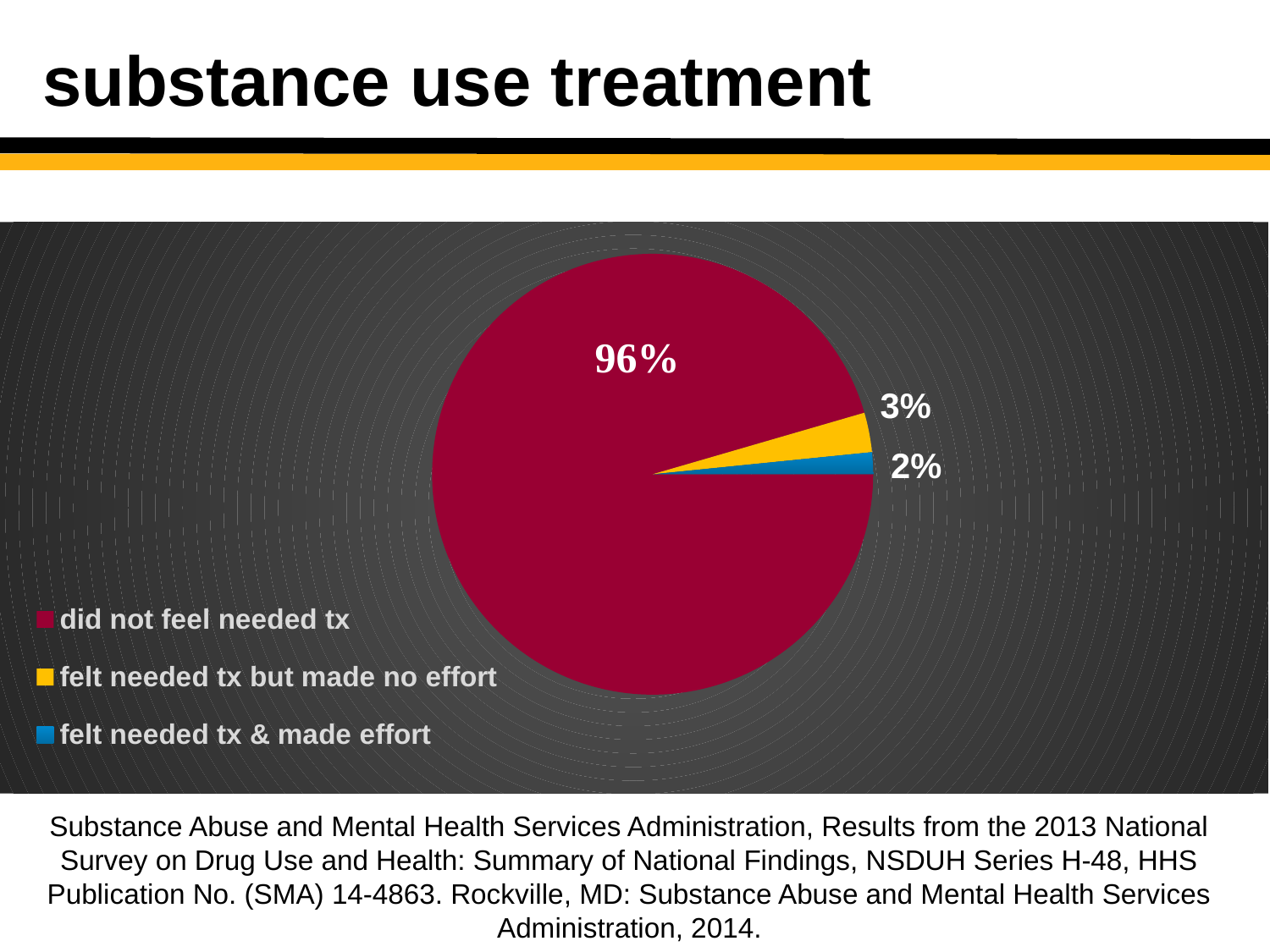
Which category has the smallest slice of the pie? felt needed tx & made effort What share of the pie is labelled "did not feel needed tx"? 96% What kind of chart is shown on the slide? pie chart Which is larger: the slice for "felt needed tx but made no effort" or the slice for "felt needed tx & made effort"? felt needed tx but made no effort What share of the pie is labelled "felt needed tx but made no effort"? 3% How many slices does the pie chart have? 3 What colour is the slice for "did not feel needed tx"? dark red What share of the pie is labelled "felt needed tx & made effort"? 2% What colour is the slice for "felt needed tx & made effort"? blue Which category has the largest slice of the pie? did not feel needed tx What is the difference in percentage points between "did not feel needed tx" and "felt needed tx but made no effort"? 93